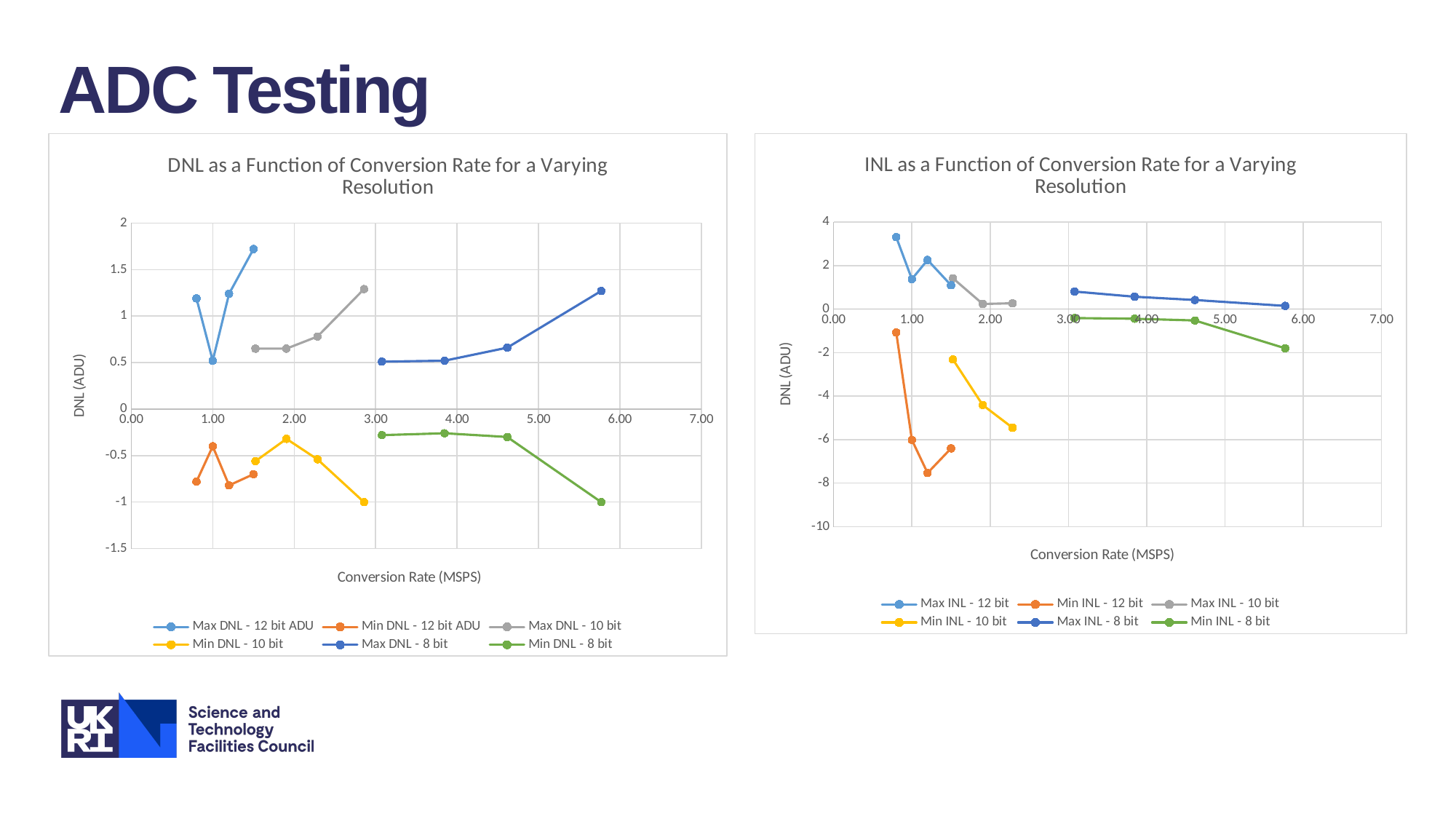
How many series does the legend of the DNL as a Function of Conversion Rate chart list? 6 In the INL chart, do the values of the Max INL - 8 bit series rise or fall as conversion rate increases? fall In the DNL chart, how many data points are plotted for the Max DNL - 8 bit series? 4 In the DNL chart, do the values of the Max DNL - 8 bit series rise or fall as conversion rate increases? rise In the INL chart, is the highest value of the Max INL - 12 bit series greater or less than 3? greater How many series does the legend of the INL as a Function of Conversion Rate chart list? 6 In the INL chart, is the value of Min INL - 10 bit at its highest conversion rate greater or less than -4? less In the DNL chart, is the value of Max DNL - 8 bit at its highest conversion rate greater or less than 1? greater What type of chart is the DNL as a Function of Conversion Rate chart? line chart What is the x-axis label of the INL as a Function of Conversion Rate chart? Conversion Rate (MSPS)